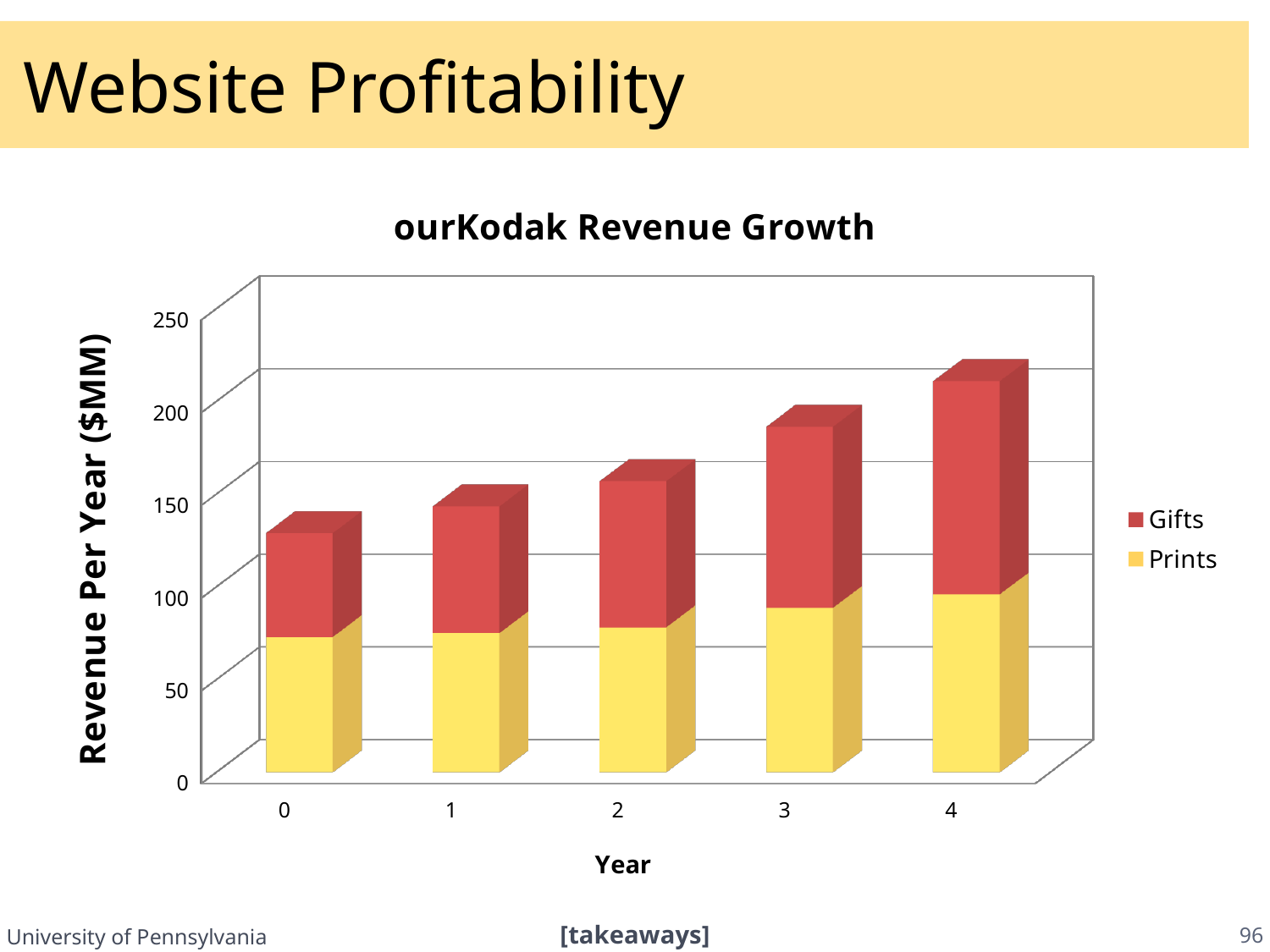
Is the Prints revenue for year 0 greater or less than 100? less How many series does the legend list? 2 What is the title of the chart? ourKodak Revenue Growth What kind of chart is shown on the slide? Stacked bar chart Which year has the highest total revenue? 4 How many years (bars) are plotted on the x axis? 5 Do total revenues rise or fall from year 0 to year 4? Rise Which year has the larger total revenue, year 1 or year 3? 3 Which is larger in year 4, the Gifts segment or the Prints segment? Gifts Is the total revenue for year 4 greater or less than 200? greater Is the total revenue for year 0 greater or less than 150? less Which year has the lowest total revenue? 0